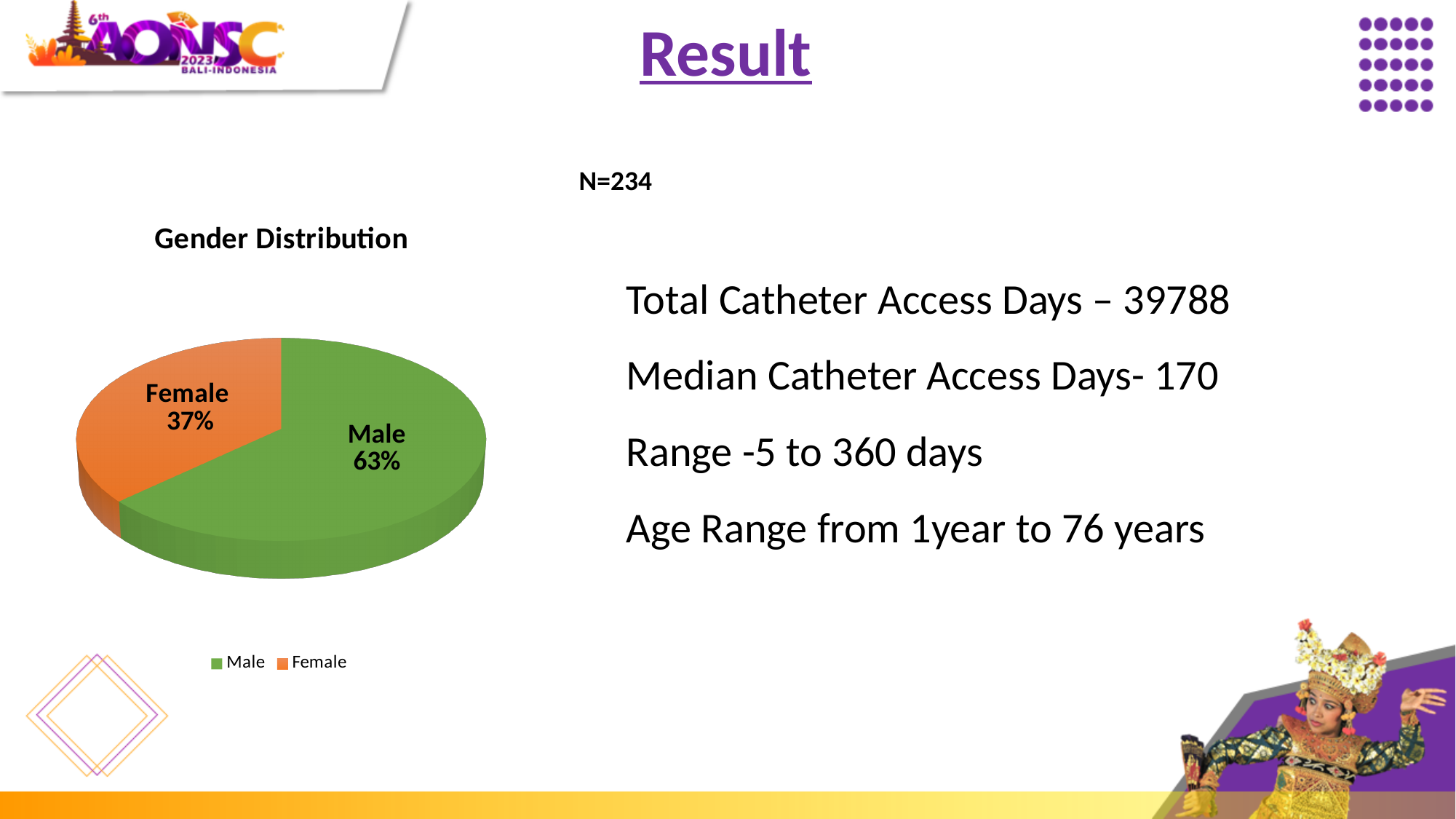
What percentage of the Gender Distribution pie chart is Female? 37% What percentage of the Gender Distribution pie chart is Male? 63% How many entries does the legend of the Gender Distribution chart list? 2 What is the difference in percentage points between the Male and Female shares in the Gender Distribution chart? 26 What is the title of the chart on the slide? Gender Distribution What type of chart is used to show the Gender Distribution? Pie chart Is the Male share larger or the Female share larger in the Gender Distribution chart? Male What share of the Gender Distribution pie does the Male slice take? 63% How many slices does the Gender Distribution pie chart have? 2 What colour represents Female in the Gender Distribution chart? Orange Which gender has the larger share in the Gender Distribution chart? Male Which gender has the smaller share in the Gender Distribution chart? Female